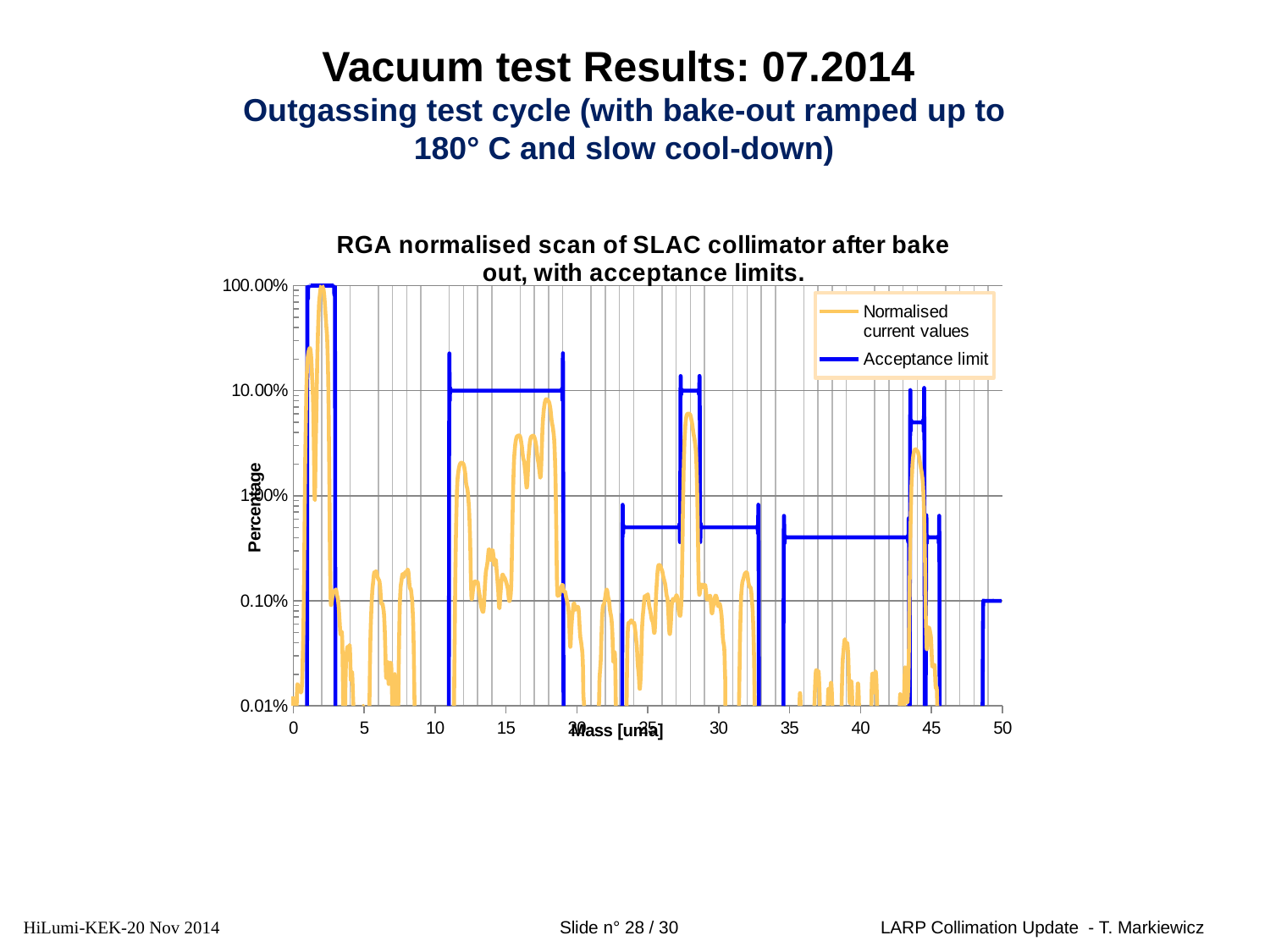
Is the peak of the normalised current values near mass 18 greater or less than 1.00%? greater Is the acceptance limit between mass 11 and 19 greater or less than 1.00%? greater What is the label of the x axis of the chart? Mass [uma] Is the peak of the normalised current values near mass 28 greater or less than 10.00%? less Near mass 28, which is higher: the acceptance limit or the normalised current values? Acceptance limit What kind of chart is shown on the slide? line chart What are the two series named in the chart legend? Normalised current values; Acceptance limit Near mass 18, which is higher: the acceptance limit or the normalised current values? Acceptance limit How many series does the chart legend list? 2